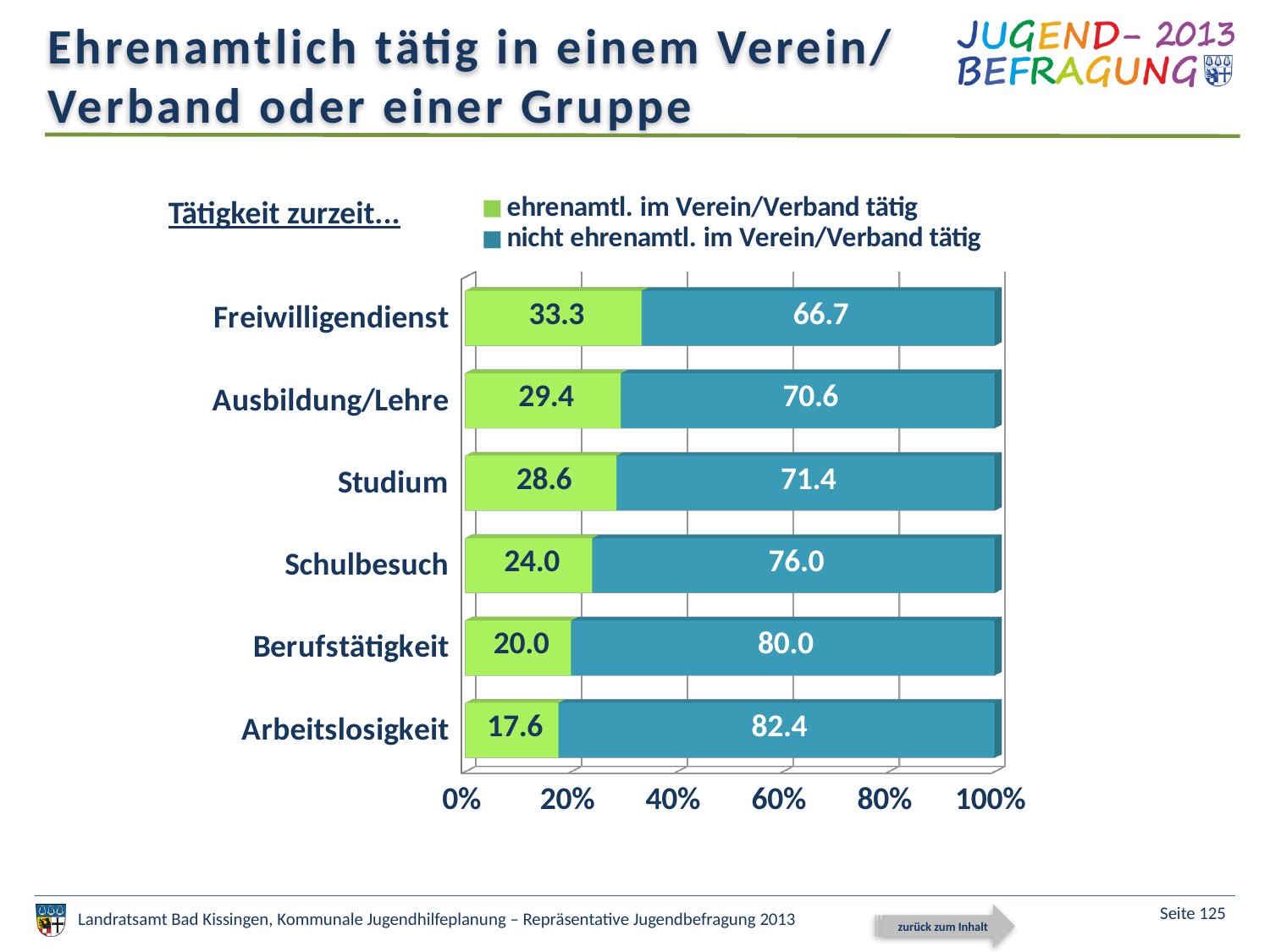
What is the total of the stacked bar for Berufstätigkeit? 100.0 How many categories are shown on the chart? 6 Which category has the highest value for 'ehrenamtl. im Verein/Verband tätig'? Freiwilligendienst Which category has the lowest value for 'ehrenamtl. im Verein/Verband tätig'? Arbeitslosigkeit How many series does the legend list? 2 What kind of chart is shown on the slide? Stacked bar chart What colour represents 'nicht ehrenamtl. im Verein/Verband tätig' in the chart? Blue What is the value for 'ehrenamtl. im Verein/Verband tätig' for Freiwilligendienst? 33.3 What is the value for 'nicht ehrenamtl. im Verein/Verband tätig' for Schulbesuch? 76.0 What is the value for 'ehrenamtl. im Verein/Verband tätig' for Arbeitslosigkeit? 17.6 Which is larger: the 'ehrenamtl. im Verein/Verband tätig' value for Schulbesuch or for Berufstätigkeit? Schulbesuch What is the difference between the 'ehrenamtl. im Verein/Verband tätig' values for Ausbildung/Lehre and Studium? 0.8